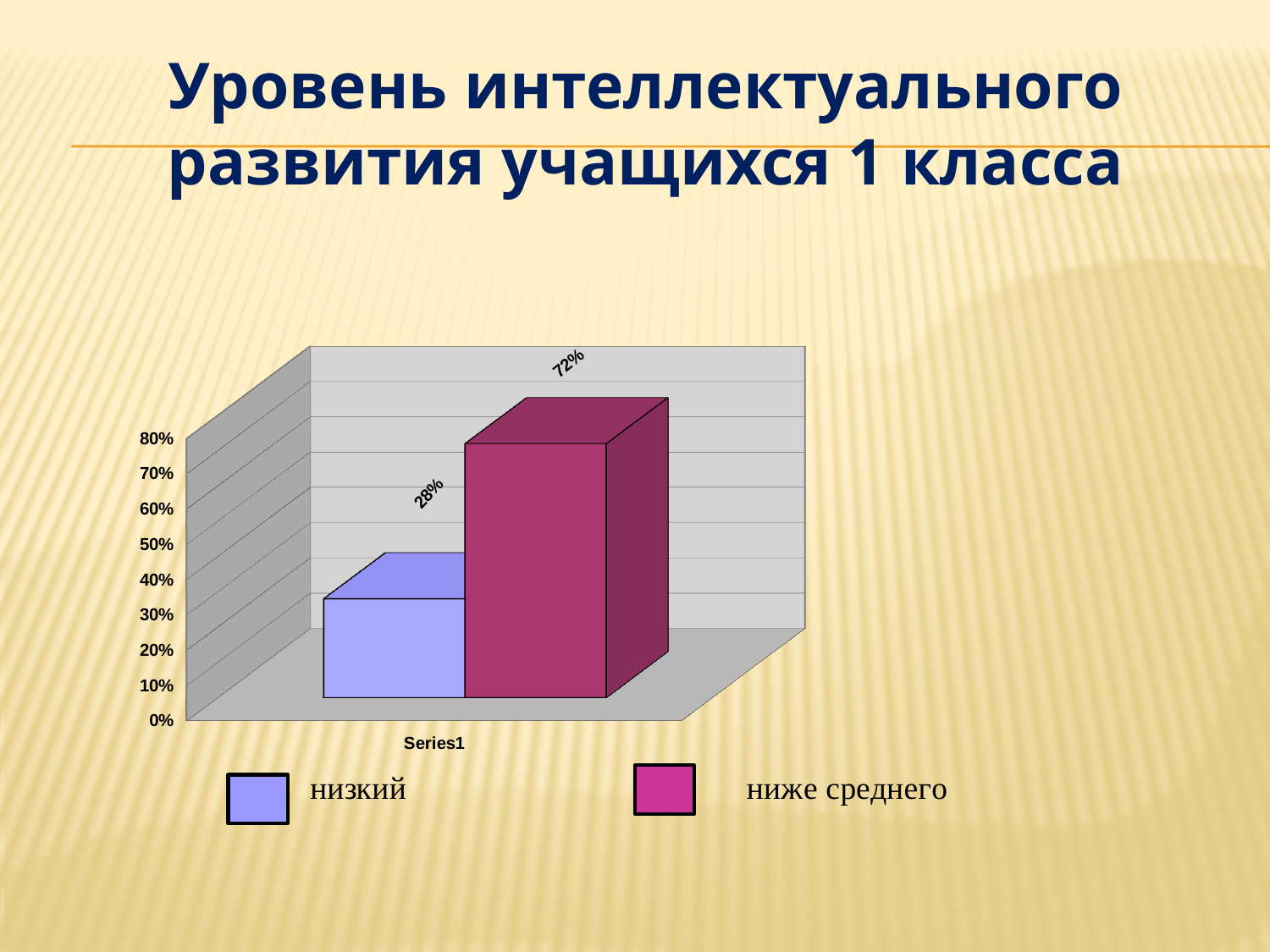
What is the value for ниже среднего? 72% What is the value for низкий? 28% How many bars are plotted in the chart? 2 What kind of chart is shown on the slide? bar chart How many entries does the legend list? 2 Which is larger, the value for низкий or the value for ниже среднего? ниже среднего Which category has the lowest value? низкий Is the value for ниже среднего greater or less than 50%? greater Is the value for низкий greater or less than 40%? less Which category has the highest value? ниже среднего What is the difference between the values for ниже среднего and низкий? 44% What is the title of the slide? Уровень интеллектуального развития учащихся 1 класса